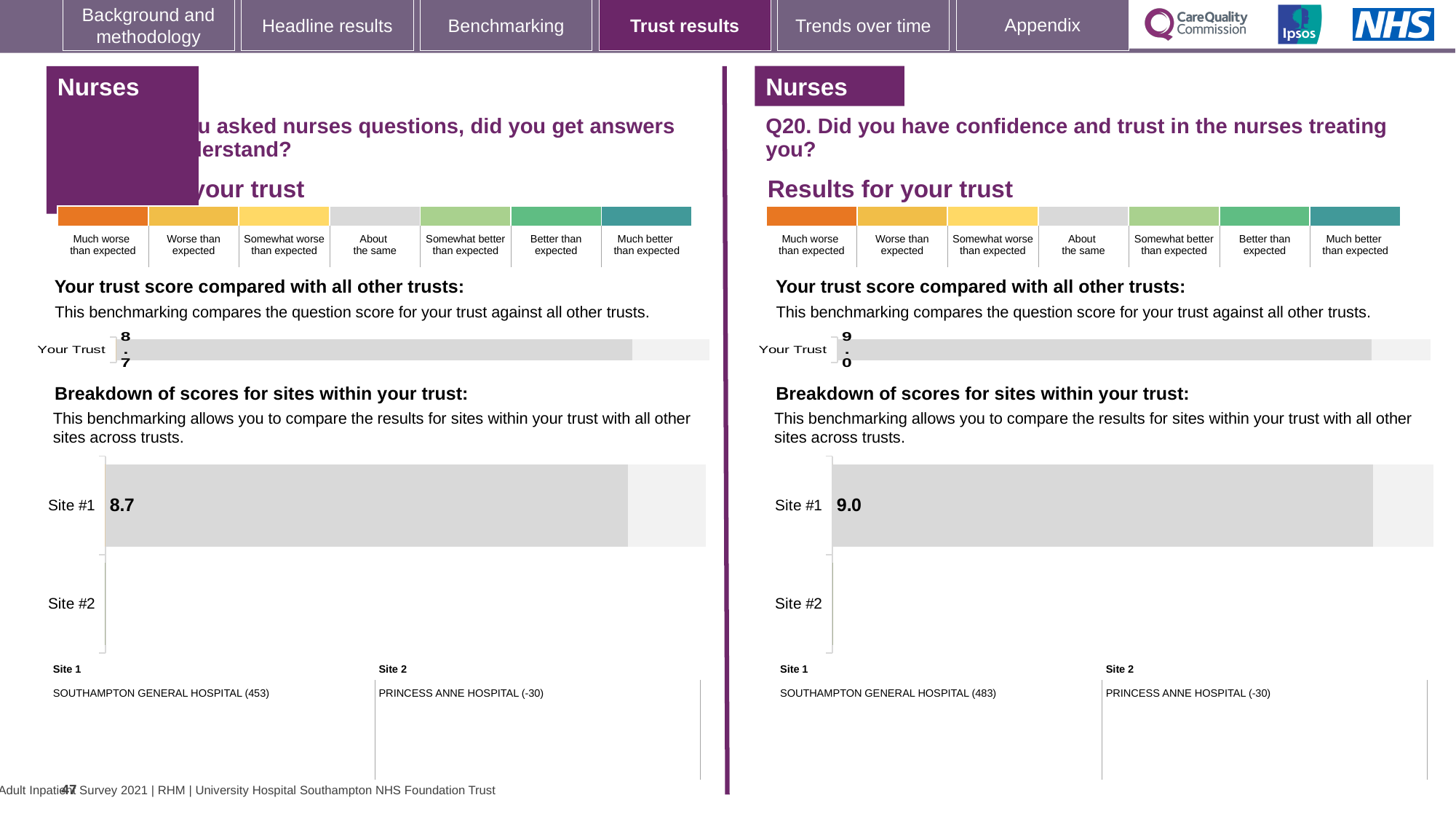
In the left-hand 'Breakdown of scores for sites within your trust' chart, what is the value for Site #1? 8.7 On the right-hand side of the slide (Q20), what is the score shown for Your Trust in the 'Your trust score compared with all other trusts' chart? 9.0 Which is larger: the Your Trust score in the left-hand chart or the Your Trust score in the right-hand chart (Q20)? The right-hand chart (Q20) How many sites are listed in the right-hand 'Breakdown of scores for sites within your trust' chart (Q20)? 2 What is the difference between the Site #1 value in the right-hand breakdown chart (Q20) and the Site #1 value in the left-hand breakdown chart? 0.3 In the right-hand 'Breakdown of scores for sites within your trust' chart (Q20), what is the value for Site #1? 9.0 Which hospital is listed as Site 1 beneath the right-hand breakdown chart (Q20)? SOUTHAMPTON GENERAL HOSPITAL (483) What type of chart is used for the 'Breakdown of scores for sites within your trust' on the right-hand side of the slide? Bar chart How many sites are listed in the left-hand 'Breakdown of scores for sites within your trust' chart? 2 On the left-hand side of the slide, what is the score shown for Your Trust in the 'Your trust score compared with all other trusts' chart? 8.7 In the right-hand breakdown chart (Q20), which site has a bar plotted with a value label? Site #1